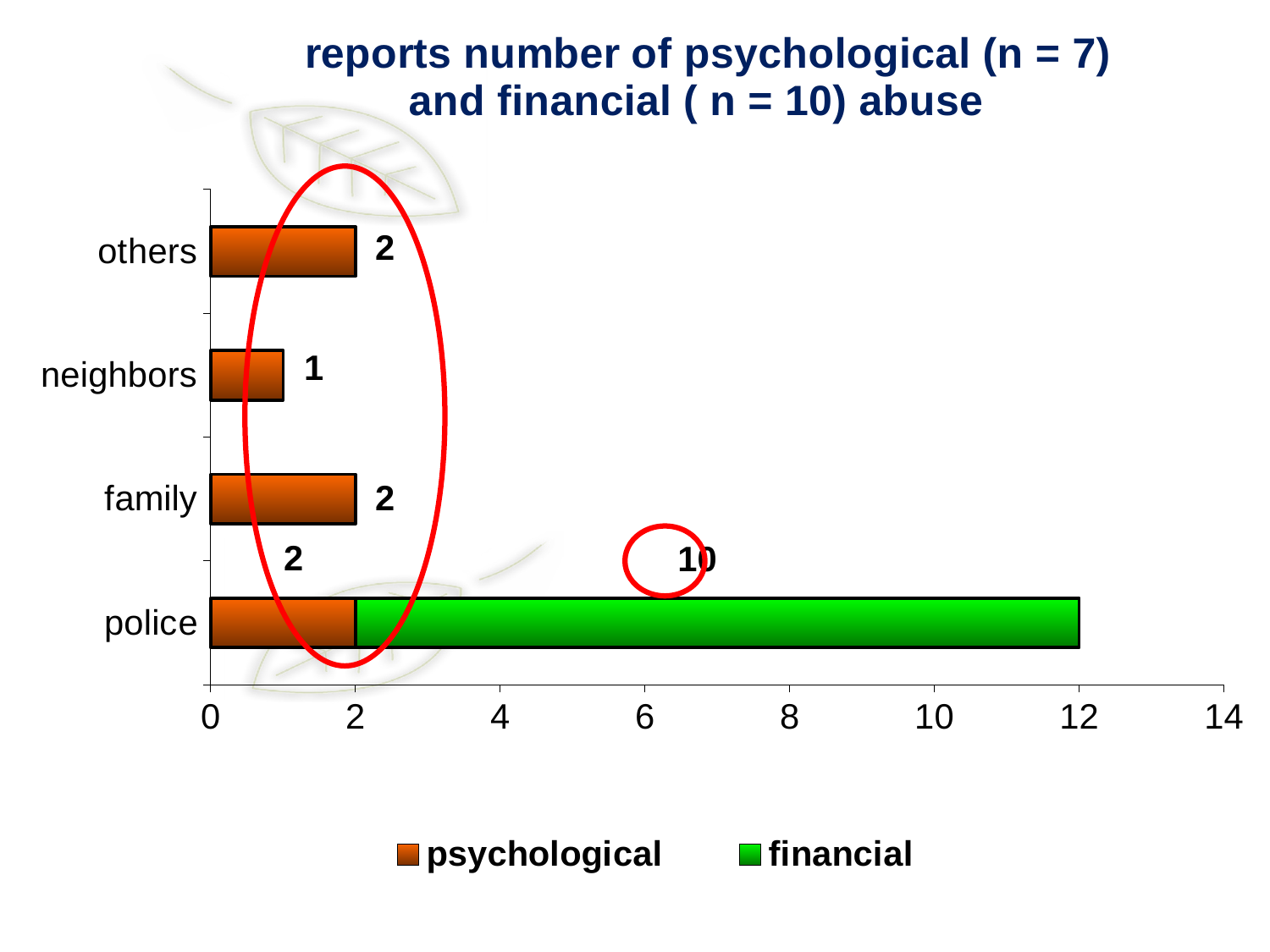
Which is larger, the psychological value for family or for neighbors? family How many series does the legend list? 2 Which category has the lowest psychological value? neighbors What is the psychological value for neighbors? 1 What kind of chart is shown on the slide? stacked bar chart Which category has the longest total bar? police What is the psychological value for others? 2 What is the difference between the financial and psychological values for police? 8 What is the psychological value for police? 2 What is the total of the stacked bar for police? 12 What is the financial value for police? 10 How many categories are shown on the y axis? 4